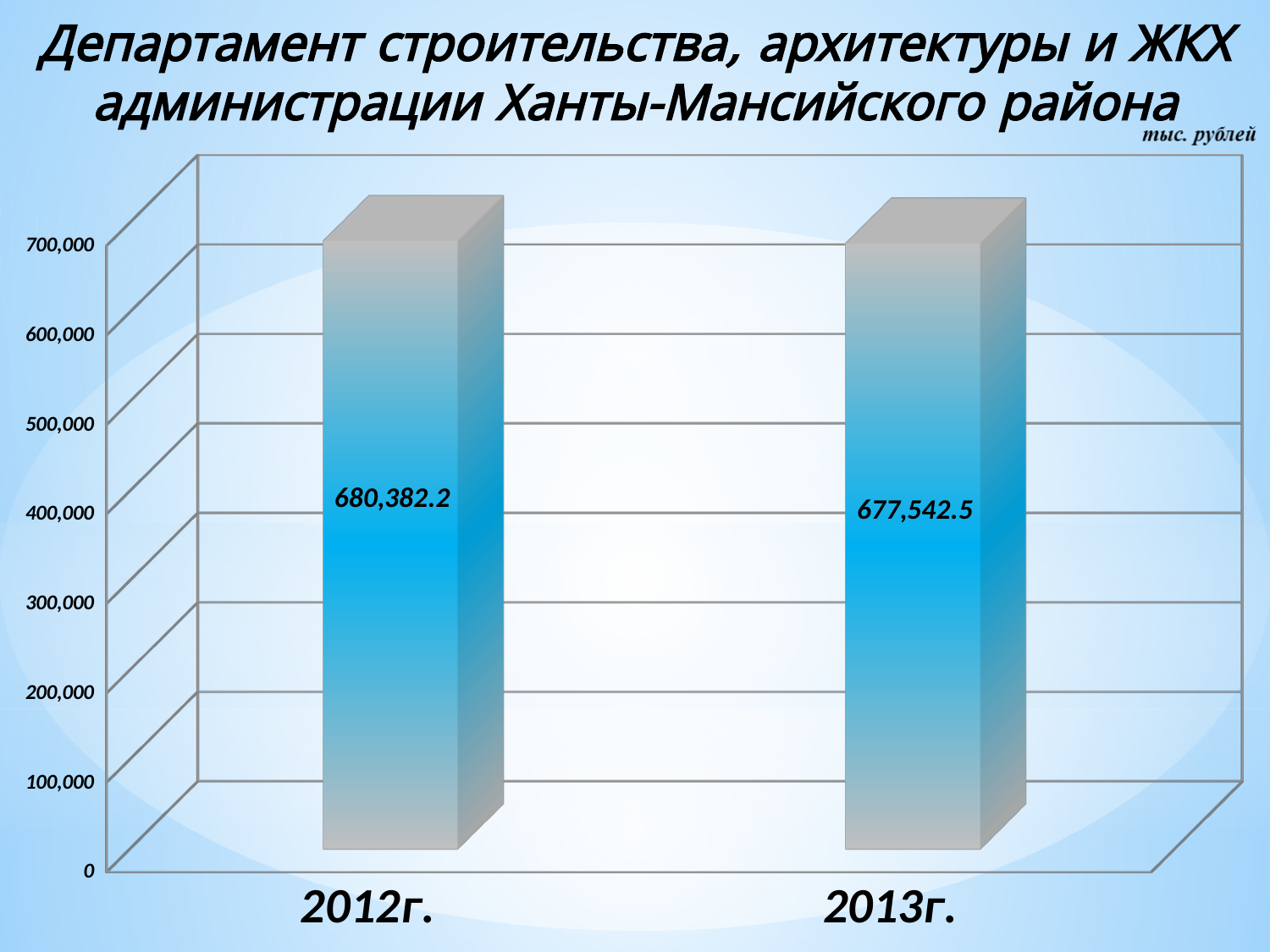
What unit is indicated for the chart values? тыс. рублей Which year has the lower value according to the data labels? 2013г. What is the value for 2012г.? 680,382.2 What is the difference between the 2012г. and 2013г. values? 2,839.7 What is the value for 2013г.? 677,542.5 How many years (categories) are shown in the chart? 2 Is the value for 2012г. larger or smaller than the value for 2013г.? larger Do the values rise or fall from 2012г. to 2013г.? fall What kind of chart is shown on the slide? bar chart Is the value for 2013г. greater or less than 600,000? greater Which year has the higher value according to the data labels? 2012г. Is the value for 2012г. greater or less than 700,000? less